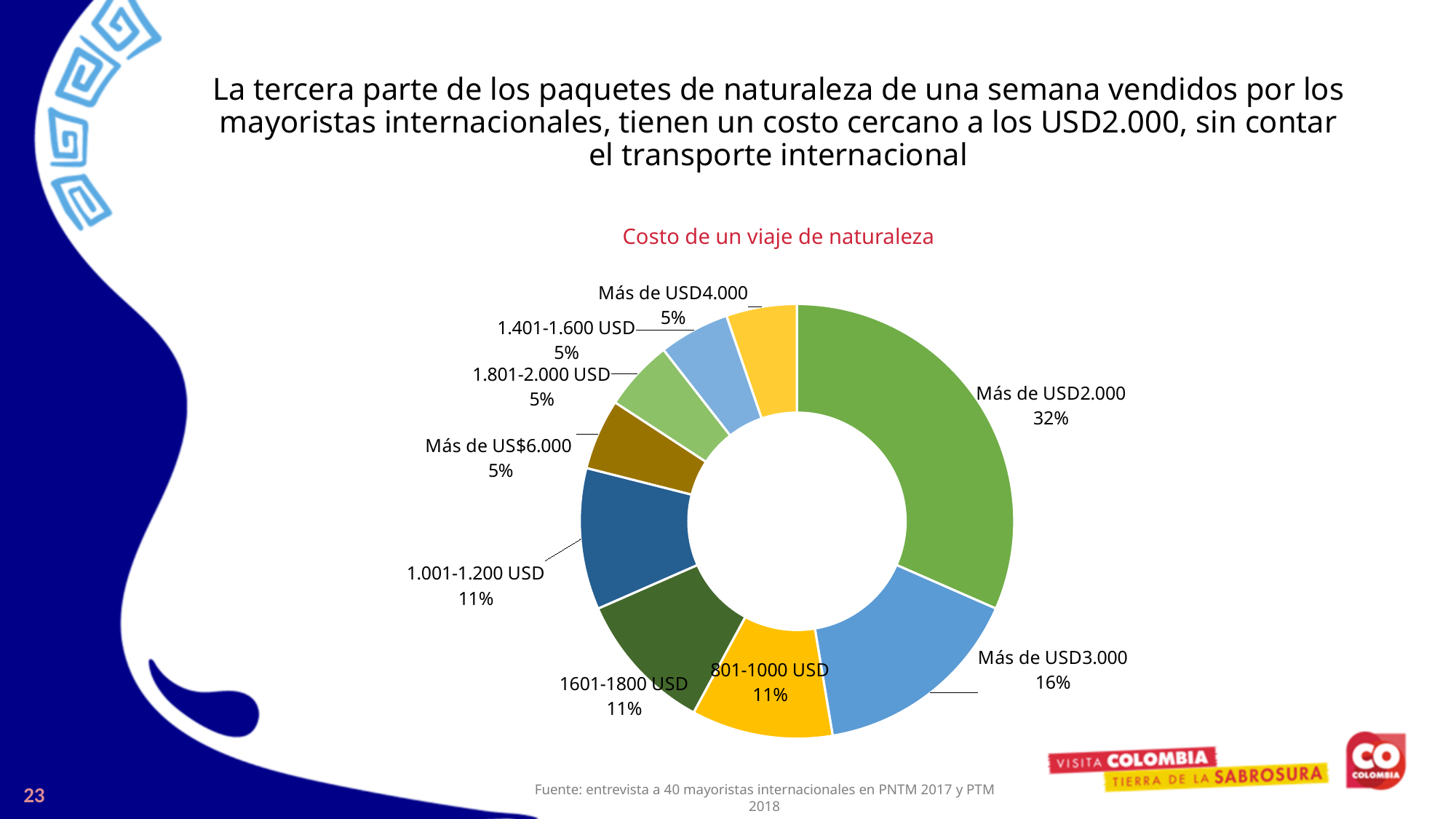
What kind of chart is shown on the slide? Pie chart (donut) What is the title of the chart? Costo de un viaje de naturaleza What is the value for '1.401-1.600 USD'? 5% Which category has the largest share of the chart? Más de USD2.000 What is the value for 'Más de USD3.000'? 16% What share of the chart does 'Más de USD2.000' represent? 32% What is the value for 'Más de US$6.000'? 5% Which is larger: the share for 'Más de USD3.000' or for '801-1000 USD'? Más de USD3.000 How many categories (slices) does the chart show? 9 What is the combined share of '801-1000 USD', '1.001-1.200 USD' and '1601-1800 USD'? 33% What is the difference between the shares of 'Más de USD2.000' and 'Más de USD3.000'? 16 percentage points What is the value for '1.001-1.200 USD'? 11%